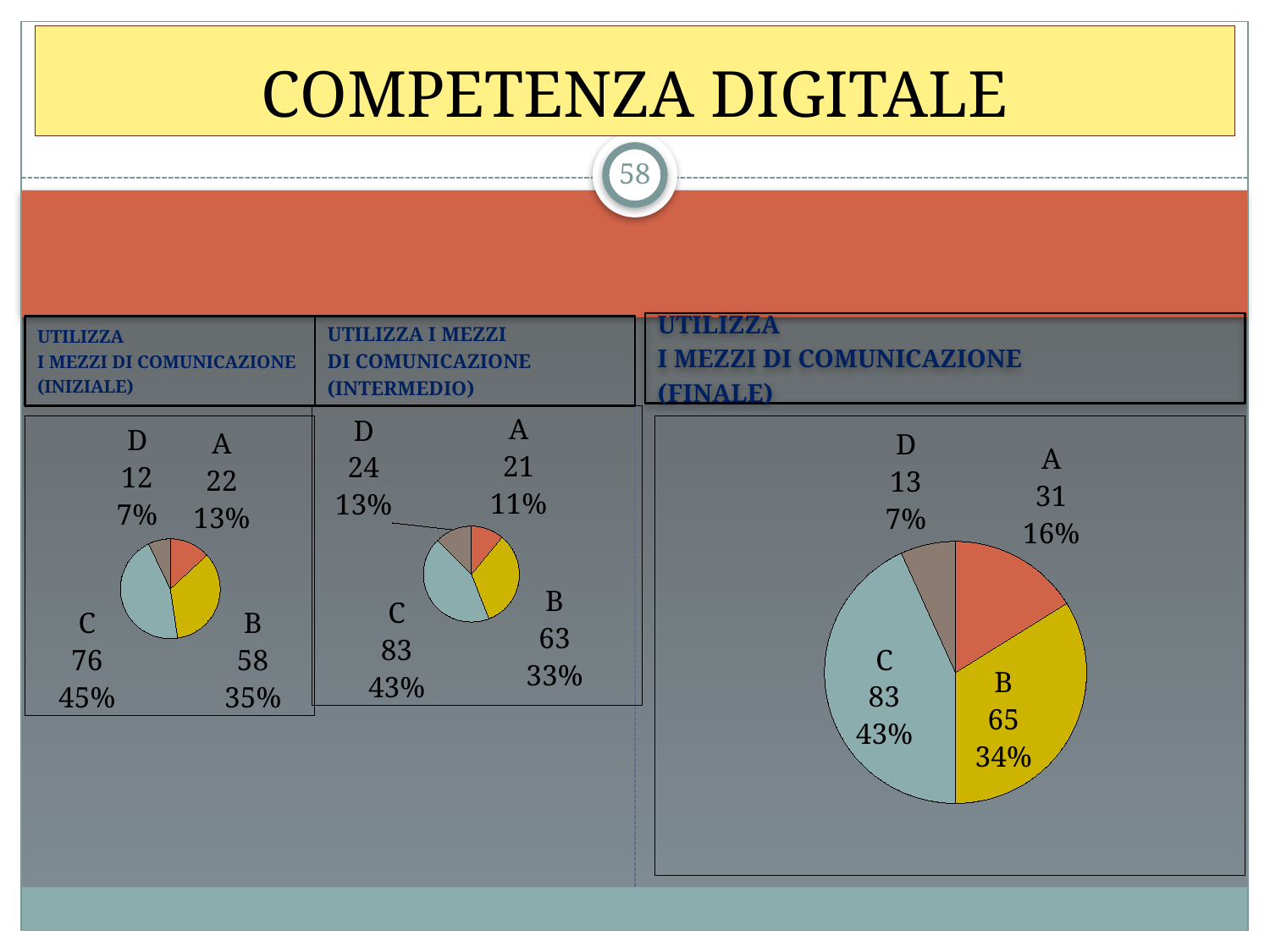
What kind of chart is used in the INIZIALE panel? Pie chart In the INTERMEDIO pie chart, what is the value for category D? 24 In the INIZIALE pie chart, what share of the pie does category B represent? 35% In the INTERMEDIO pie chart, what is the difference between the values for C and B? 20 In the FINALE pie chart, what share of the pie does category C represent? 43% In the FINALE pie chart, which is larger, the value for B or the value for A? B How many pie charts are shown on the slide? 3 In the FINALE pie chart, what is the value for category A? 31 In the INTERMEDIO pie chart, which category has the highest value? C How many categories does the FINALE pie chart show? 4 In the INIZIALE pie chart, what is the value for category C? 76 In the INIZIALE pie chart, which category has the lowest value? D